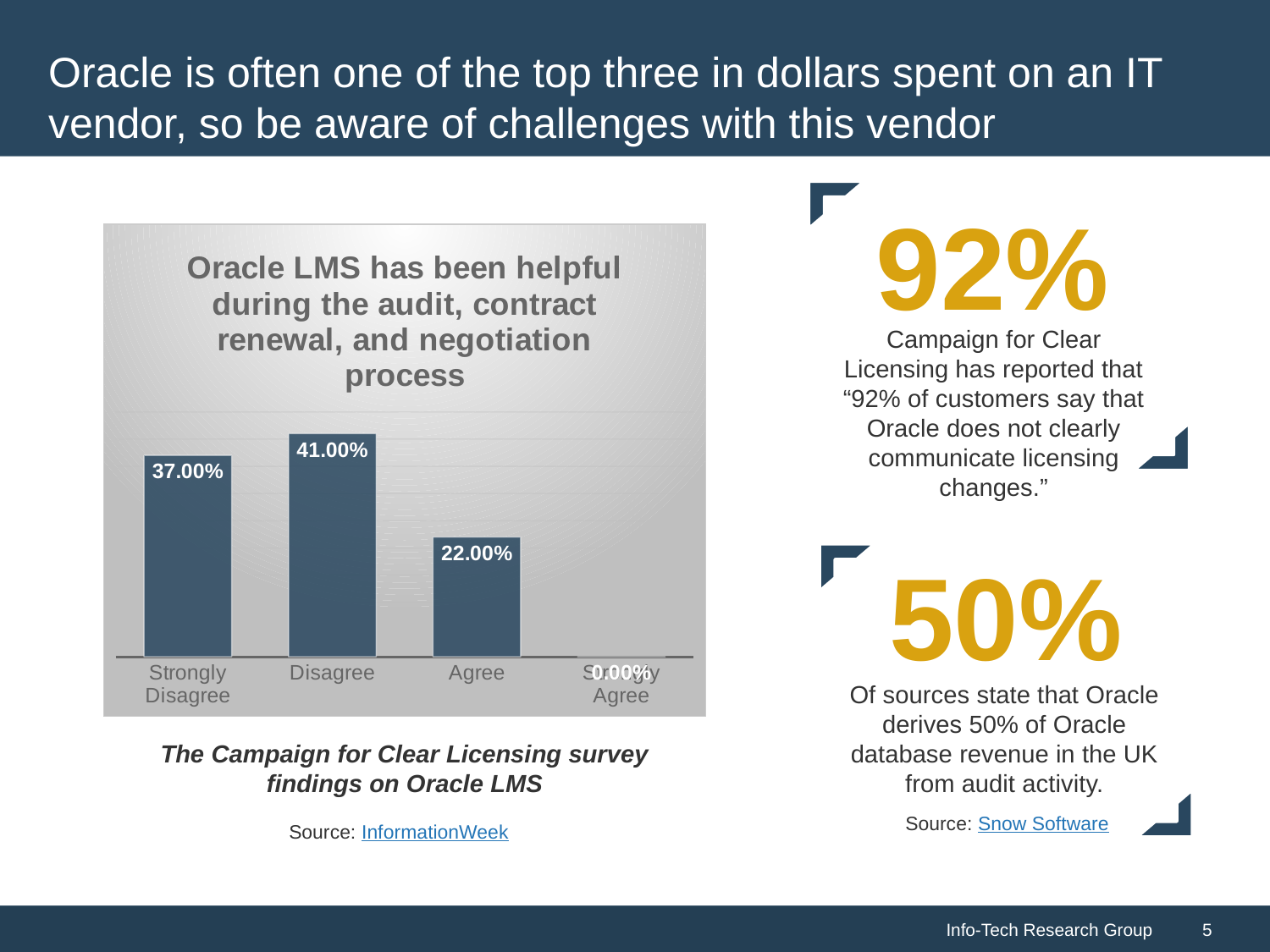
What is the title of the chart? Oracle LMS has been helpful during the audit, contract renewal, and negotiation process What is the value for Strongly Agree? 0.00% What is the value for Disagree? 41.00% Which category has the lowest value? Strongly Agree What is the value for Strongly Disagree? 37.00% What is the difference between the values for Disagree and Agree? 19.00% Which category has the highest value? Disagree How many categories are shown on the x axis? 4 Which is larger, the value for Strongly Disagree or the value for Agree? Strongly Disagree What kind of chart is shown? Bar chart What is the difference between the values for Disagree and Strongly Disagree? 4.00% What is the value for Agree? 22.00%